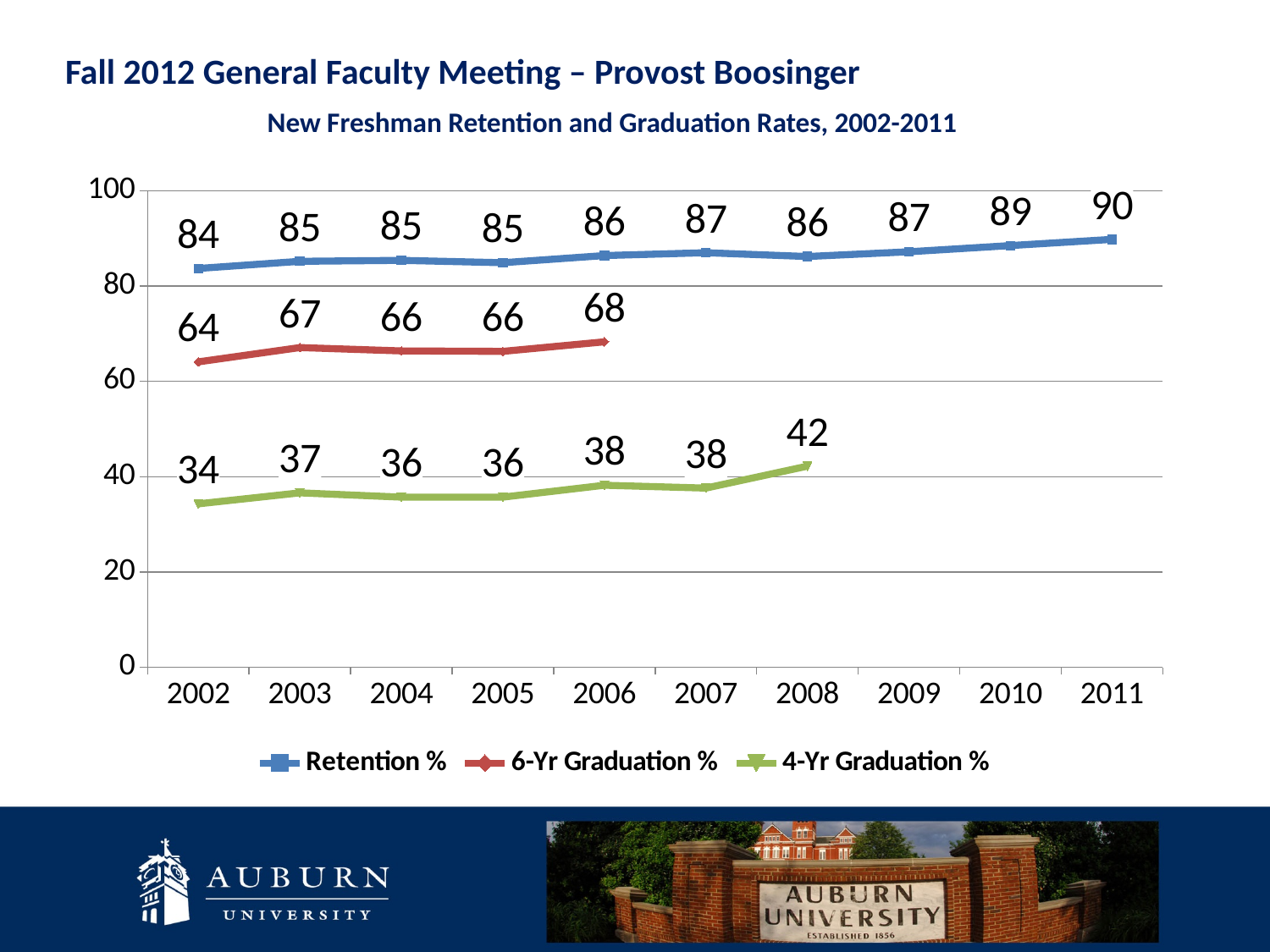
How many years are shown on the x axis? 10 What is the difference between the Retention % in 2011 and in 2002? 6 How many series does the legend list? 3 What is the 6-Yr Graduation % value for 2006? 68 Which is larger in 2003: the 6-Yr Graduation % or the 4-Yr Graduation %? 6-Yr Graduation % In which year is the Retention % lowest? 2002 What is the 4-Yr Graduation % value for 2008? 42 What is the Retention % value for 2011? 90 Does the Retention % generally rise or fall from 2002 to 2011? Rise In which year is the 4-Yr Graduation % highest? 2008 What kind of chart is this? Line chart What is the title of the chart? New Freshman Retention and Graduation Rates, 2002-2011